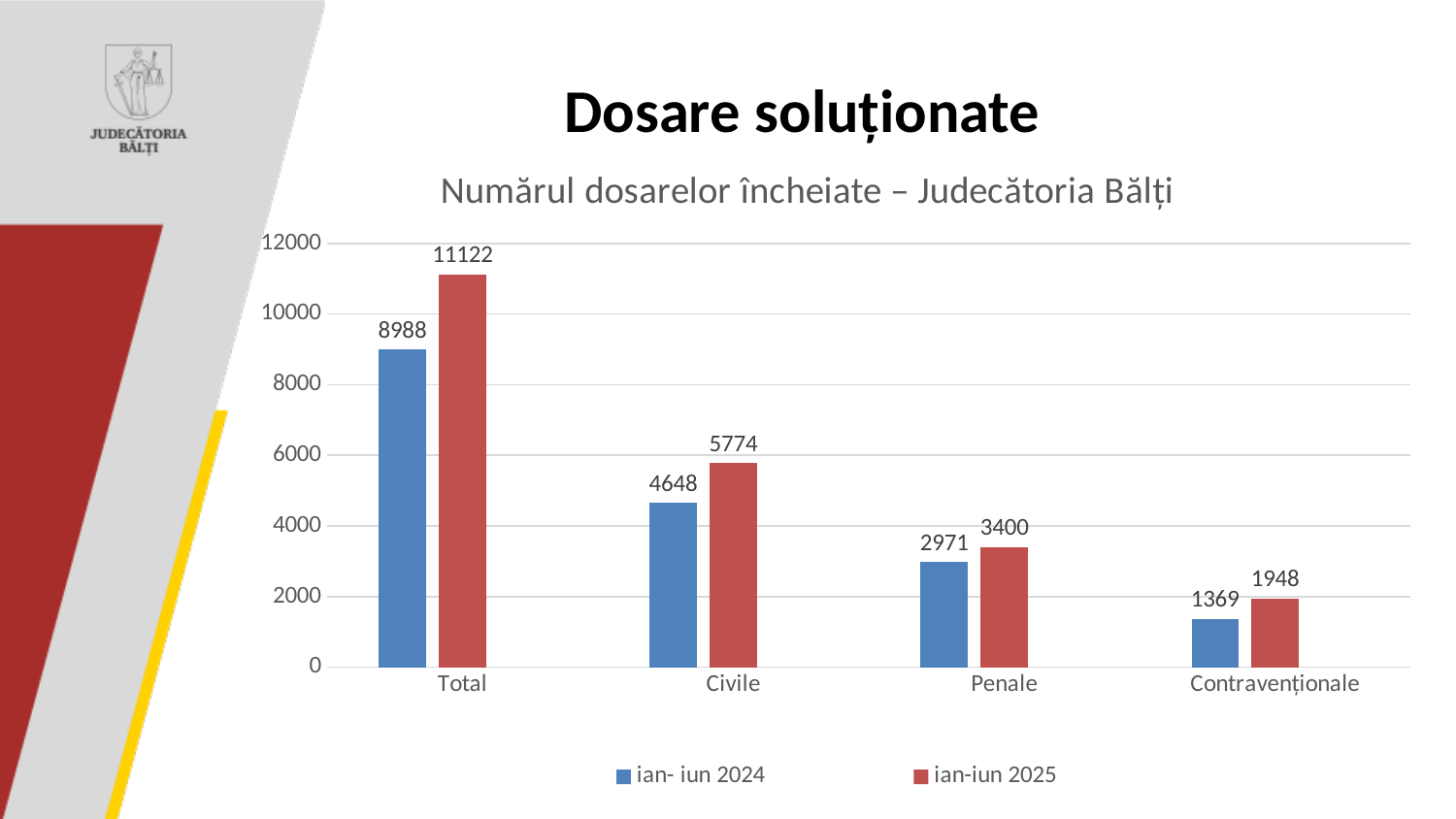
How many categories are shown on the x axis? 4 Which category has the lowest value in the ian- iun 2024 series? Contravenționale What is the value for Civile in the ian-iun 2025 series? 5774 Which is larger for Penale: the ian- iun 2024 value or the ian-iun 2025 value? ian-iun 2025 What is the difference between the ian-iun 2025 and ian- iun 2024 values for Civile? 1126 How many series does the legend list? 2 Is the ian- iun 2024 value for Civile greater or less than 4000? greater What is the difference between the ian-iun 2025 and ian- iun 2024 values for Total? 2134 What is the value for Contravenționale in the ian-iun 2025 series? 1948 What is the value for Penale in the ian- iun 2024 series? 2971 What kind of chart is shown on the slide? bar chart Which category has the highest value in the ian-iun 2025 series? Total